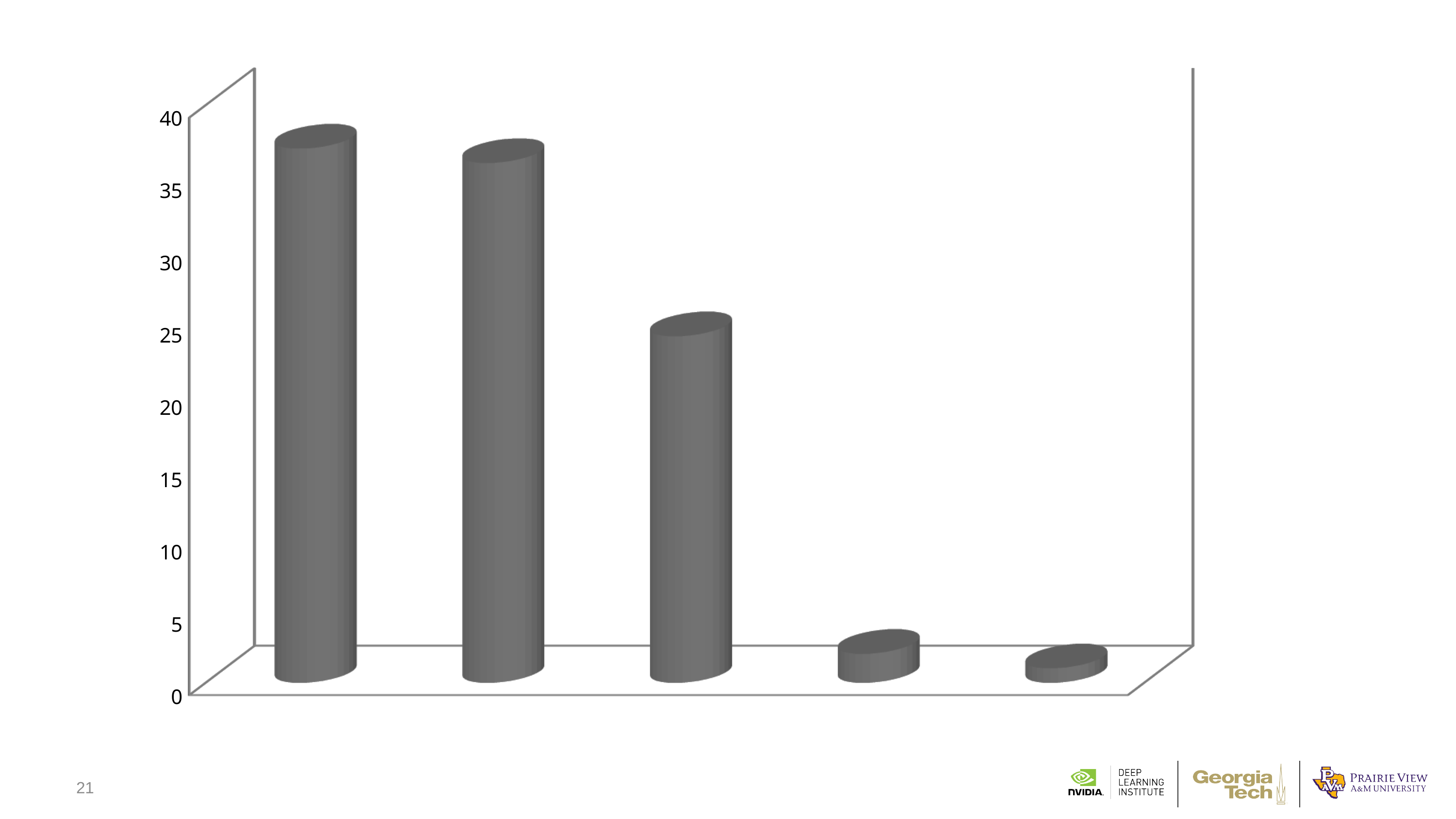
Which is larger, the second bar from the left or the rightmost bar? the second bar from the left Which is larger, the leftmost bar or the third bar from the left? the leftmost bar Do the bar values rise or fall from left to right across the chart? fall What kind of chart is shown on the slide? bar chart Is the value of the rightmost bar greater or less than 5? less How many bars are plotted in the chart? 5 What is the highest value shown on the vertical axis? 40 Is the value of the second bar from the left greater or less than 30? greater Is the value of the fourth bar from the left greater or less than 10? less